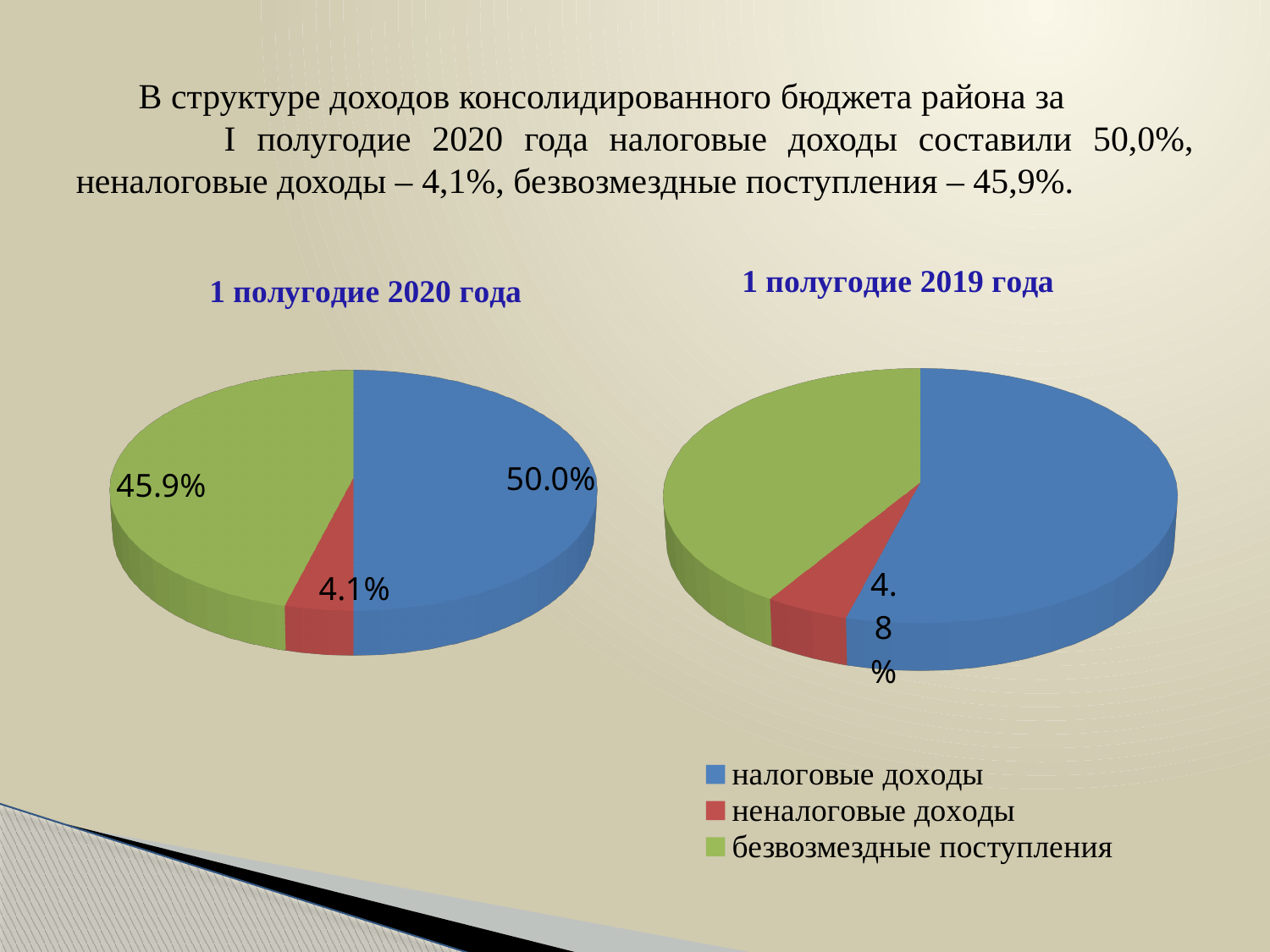
In the chart titled "1 полугодие 2020 года", what is the difference between the shares of налоговые доходы and безвозмездные поступления? 4.1% In the chart titled "1 полугодие 2019 года", which category has the largest slice? налоговые доходы In the chart titled "1 полугодие 2020 года", which category has the smallest slice? неналоговые доходы In the chart titled "1 полугодие 2020 года", what share does the slice for безвозмездные поступления have? 45.9% What type of chart is used on this slide? pie chart How many categories does the legend list? 3 In the chart titled "1 полугодие 2020 года", which category has the largest slice? налоговые доходы In the chart titled "1 полугодие 2020 года", what share does the slice for неналоговые доходы have? 4.1% In the chart titled "1 полугодие 2020 года", what share does the slice for налоговые доходы have? 50.0% In the chart titled "1 полугодие 2019 года", which slice is larger: налоговые доходы or безвозмездные поступления? налоговые доходы In the chart titled "1 полугодие 2019 года", what share does the slice for неналоговые доходы have? 4.8% In the chart titled "1 полугодие 2019 года", which category has the smallest slice? неналоговые доходы